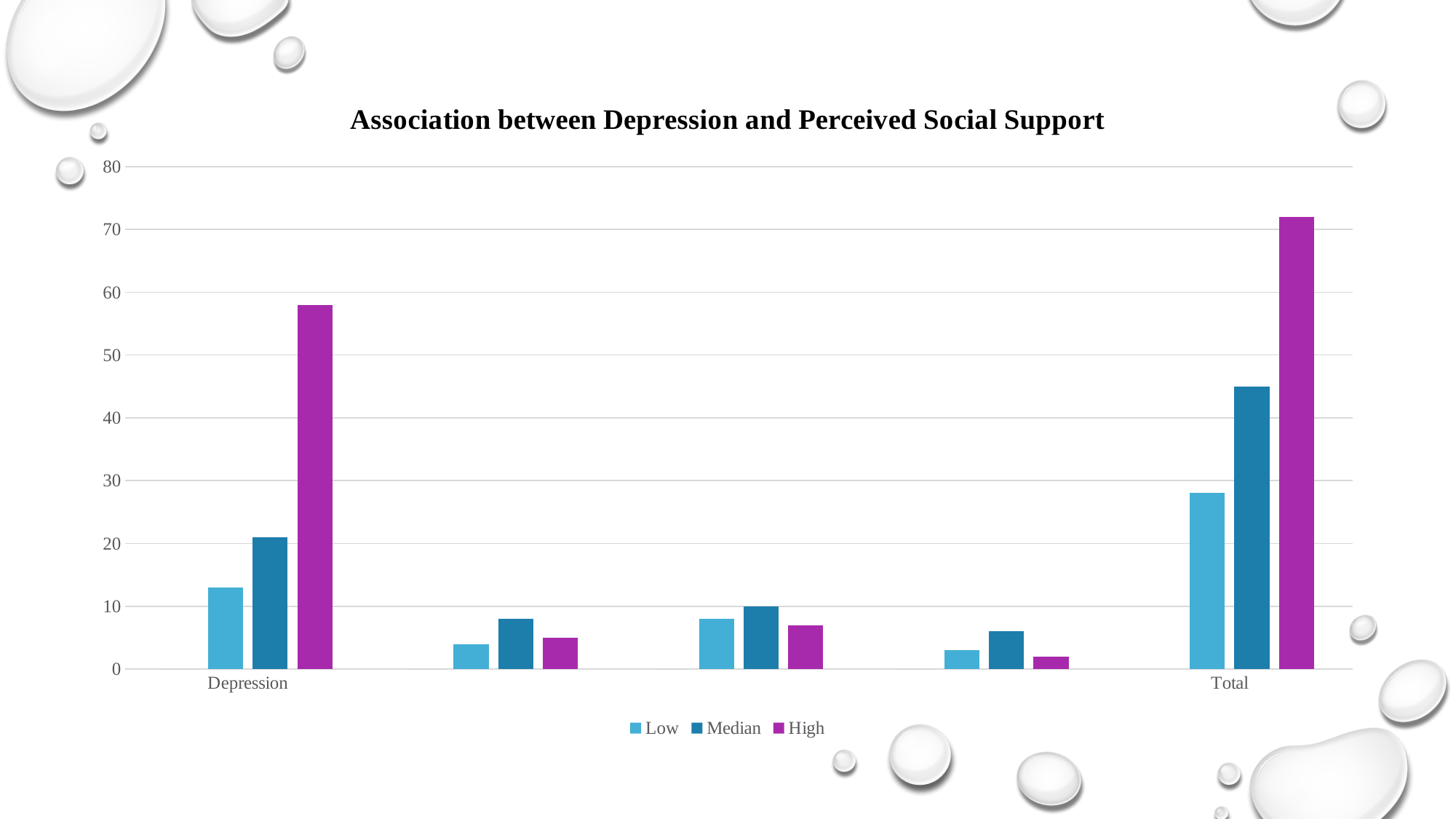
Is the value for Low in the Depression category greater or less than 20? less Is the value for High in the Total category greater or less than 70? greater Is the value for High in the Depression category greater or less than 50? greater What kind of chart is shown on the slide? bar chart Which series has the highest value in the Total category? High In the Depression category, which is larger, the Median value or the High value? High Which series has the lowest value in the Depression category? Low What is the title of the chart? Association between Depression and Perceived Social Support How many groups of bars are plotted along the x axis? 5 How many series does the legend list? 3 Which series is shown in purple in the legend? High